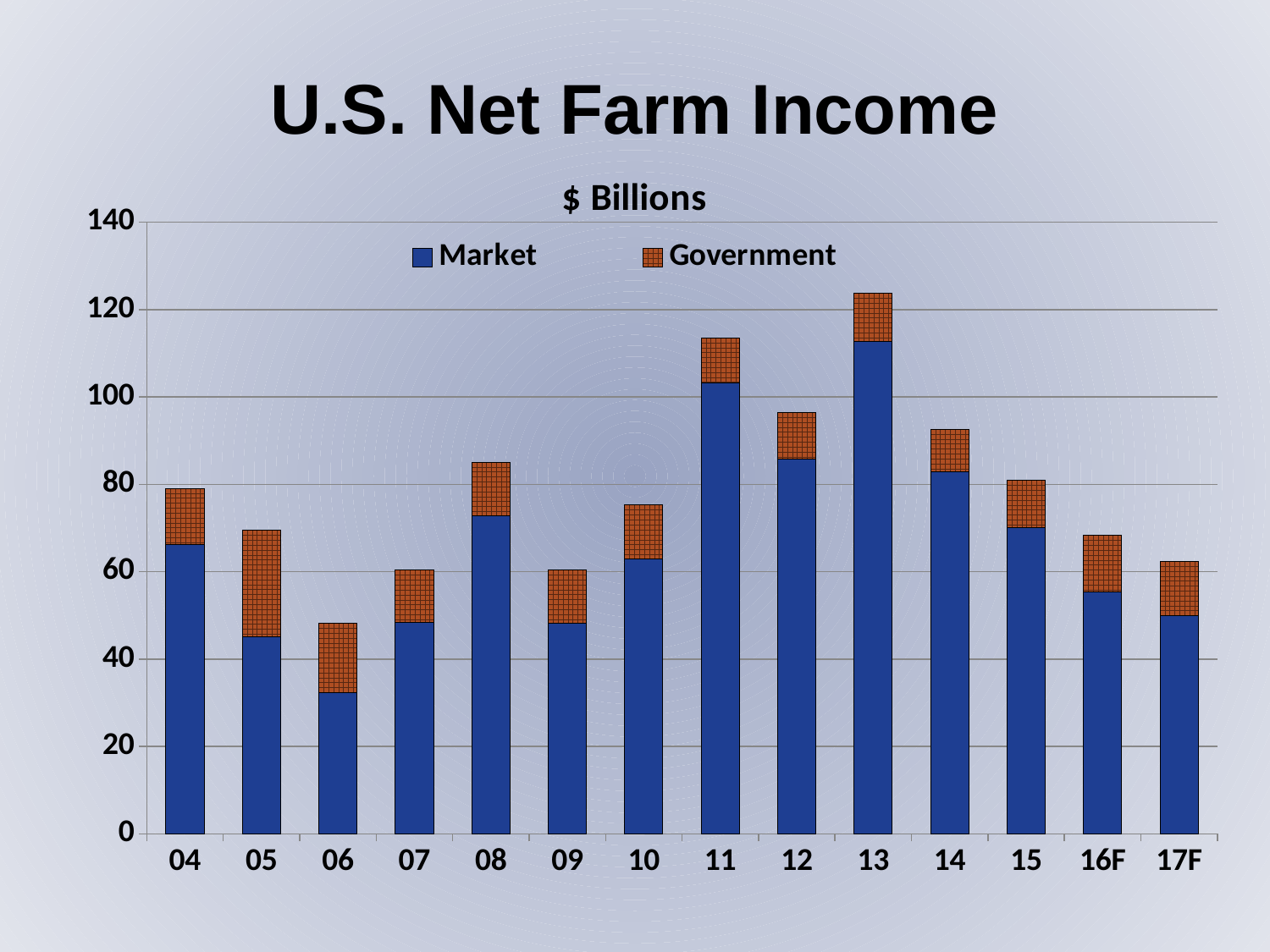
Is the Market value for 05 greater or less than 60? less Which year has the larger total net farm income, 11 or 12? 11 How many series does the legend list? 2 How many years are shown on the x axis? 14 Which year has the highest total net farm income? 13 Is the total value for 06 greater or less than 60? less Do the total values rise or fall from 13 to 17F? fall Is the Market value for 11 greater or less than 100? greater What unit is stated in the chart's subtitle? $ Billions What kind of chart is shown on the slide? Stacked bar chart Which year has the lowest total net farm income? 06